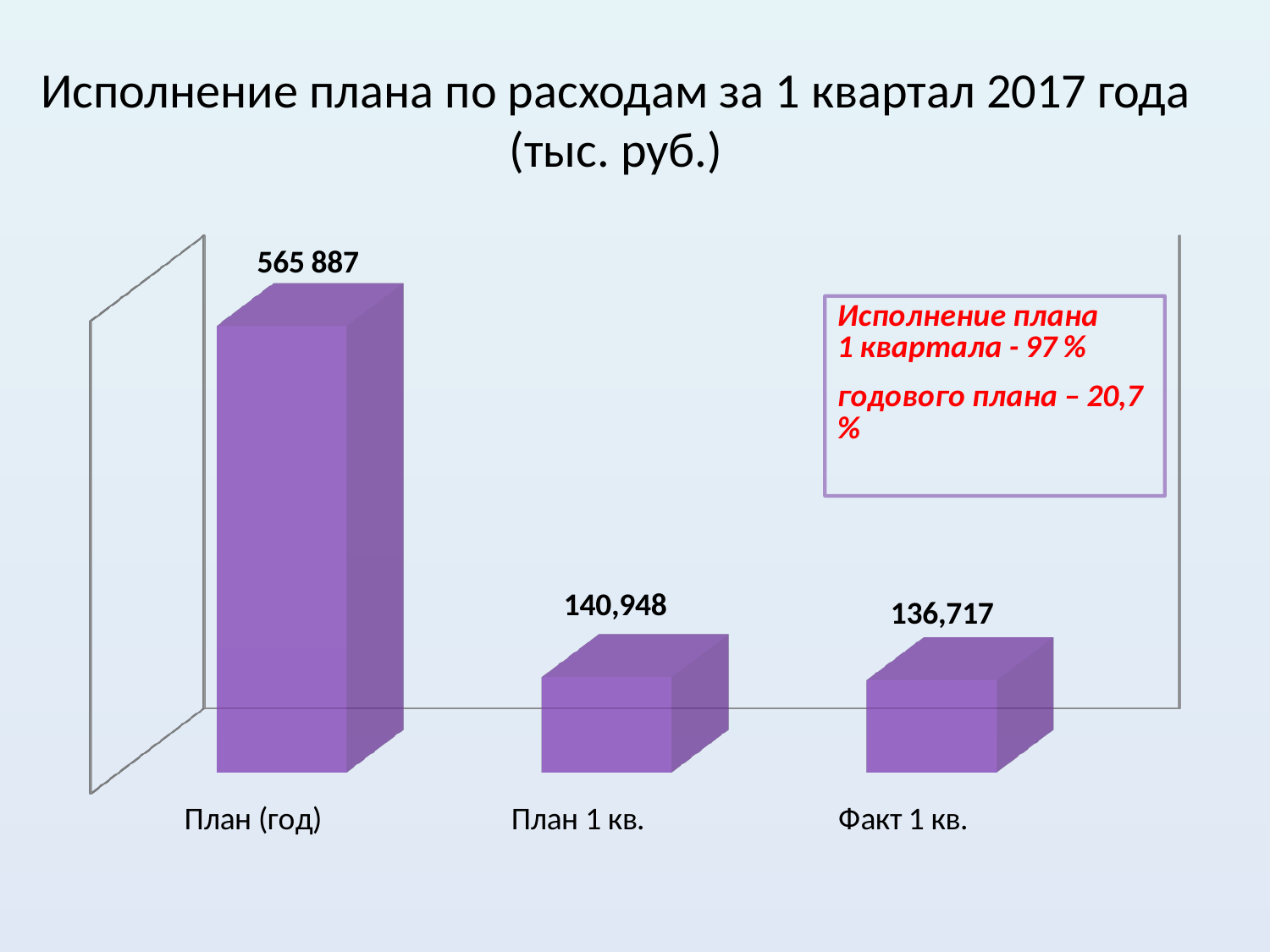
Which category has the lowest value? Факт 1 кв. Which is larger, the value for План (год) or the value for План 1 кв.? План (год) What is the title of the slide? Исполнение плана по расходам за 1 квартал 2017 года (тыс. руб.) What colour are the bars in the chart? Purple Which category has the highest value? План (год) How many categories are shown in the chart? 3 What kind of chart is shown on the slide? Bar chart What is the difference between the values for План 1 кв. and Факт 1 кв.? 4,231 Do the values rise or fall from left to right across the categories? Fall What is the value for План 1 кв.? 140,948 What is the value for Факт 1 кв.? 136,717 What is the value for План (год)? 565 887